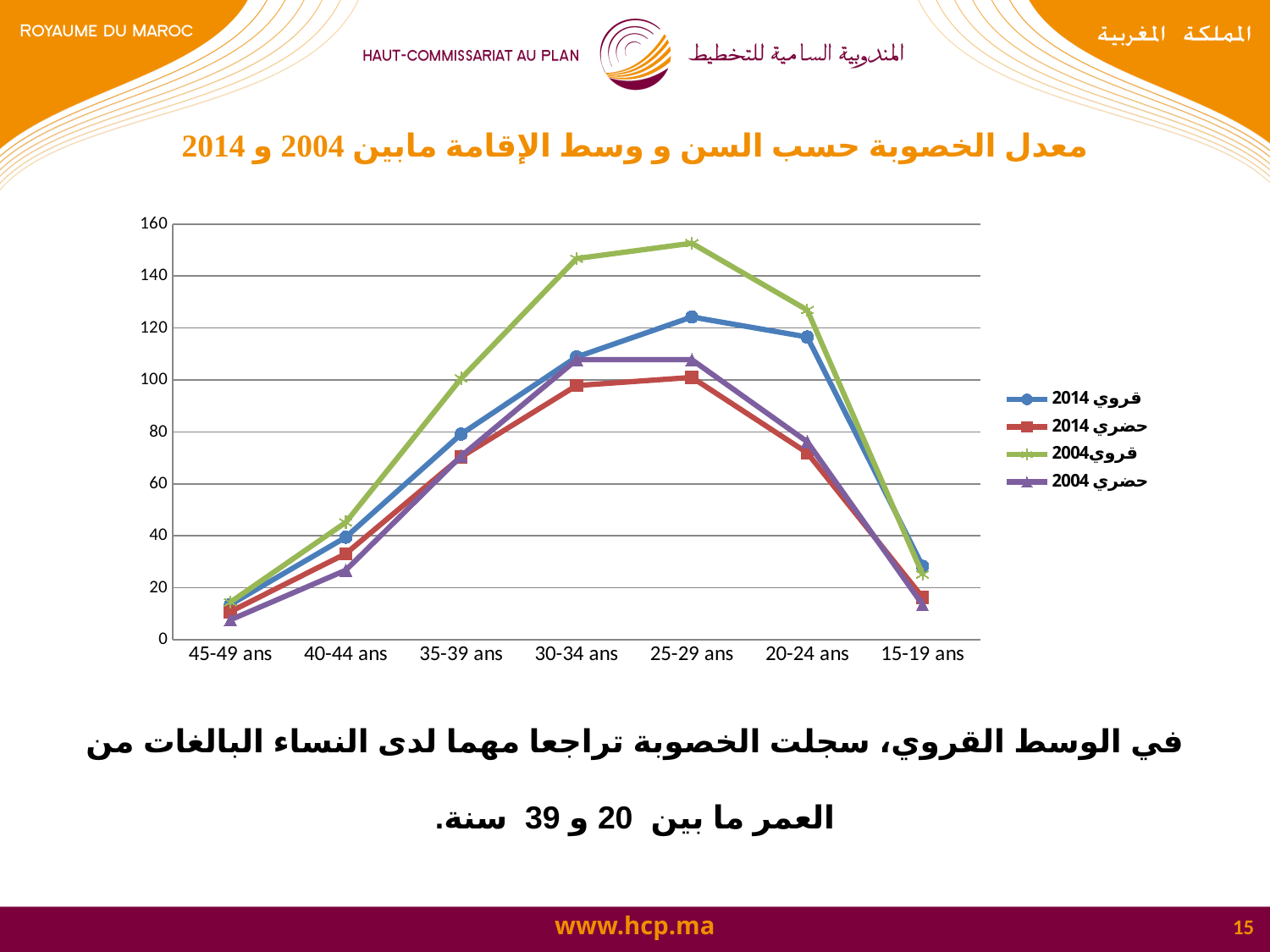
Is the value for قروي2004 at 25-29 ans greater or less than 140? greater Is the value for قروي 2014 at 20-24 ans greater or less than 100? greater Is the value for حضري 2004 at 45-49 ans greater or less than 20? less Which series has the highest value at 25-29 ans? قروي2004 How many age groups are shown on the x axis of the chart? 7 What kind of chart is shown on the slide? line chart Does the value for قروي 2014 rise or fall from 45-49 ans to 25-29 ans? rise At 35-39 ans, which is larger: the value for قروي2004 or the value for حضري 2014? قروي2004 Which series is drawn in green in the chart? قروي2004 For the series قروي 2014, which age group has the highest value? 25-29 ans How many series does the chart legend list? 4